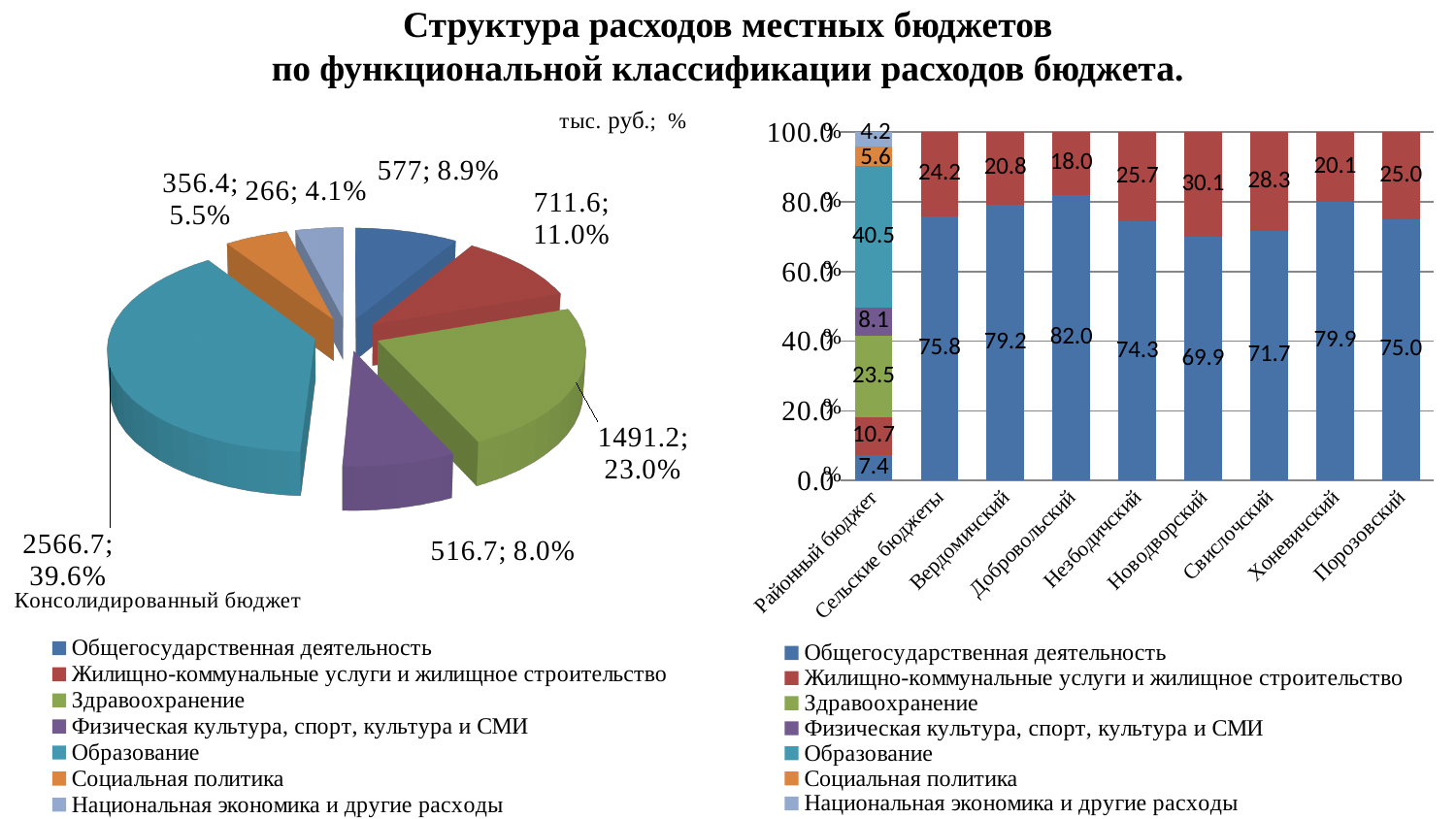
On the right bar chart, which budget has the highest value for Жилищно-коммунальные услуги и жилищное строительство? Новодворский On the left pie chart, which category has the largest slice? Образование On the right bar chart, what is the value of Общегосударственная деятельность for Добровольский? 82.0 On the left pie chart, what is the difference in thousand rubles between Жилищно-коммунальные услуги и жилищное строительство (711.6) and Общегосударственная деятельность (577)? 134.6 On the left pie chart, which category has the smallest slice? Национальная экономика и другие расходы On the right bar chart, what is the value of Образование for Районный бюджет? 40.5 How many series does the legend of the right bar chart list? 7 On the left pie chart, what percentage share is shown for Здравоохранение? 23.0% On the right bar chart, which is larger: the Общегосударственная деятельность value for Вердомичский or for Незбодичский? Вердомичский What type of chart is on the right side of the slide? Stacked bar chart On the left pie chart, how many slices are there? 7 On the left pie chart (Консолидированный бюджет), what value is shown for Образование? 2566.7; 39.6%